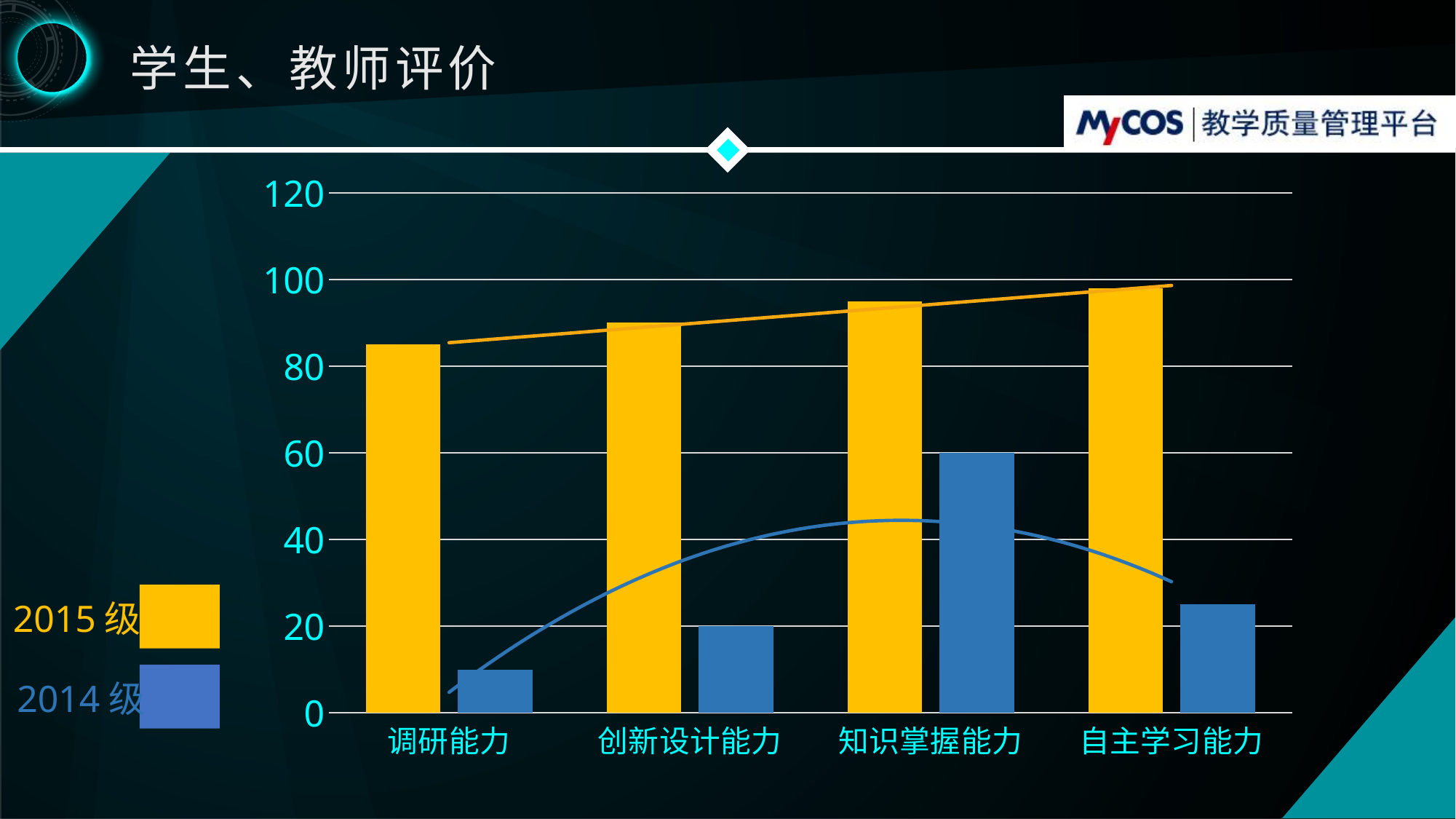
How many series does the legend list? 2 Is the value for 2015级 in 调研能力 greater or less than 80? greater What is the value for 2014级 in the 知识掌握能力 category? 60 Which category has the lowest value for 2015级? 调研能力 Which category has the lowest value for 2014级? 调研能力 Which colour represents the 2015级 series in the legend? yellow What kind of chart is shown on the slide? bar chart Which category has the highest value for 2014级? 知识掌握能力 Is the value for 2014级 in 自主学习能力 greater or less than 40? less Do the 2015级 values rise or fall from 调研能力 to 自主学习能力? rise What is the value for 2014级 in the 创新设计能力 category? 20 How many categories are shown on the x axis of the chart? 4